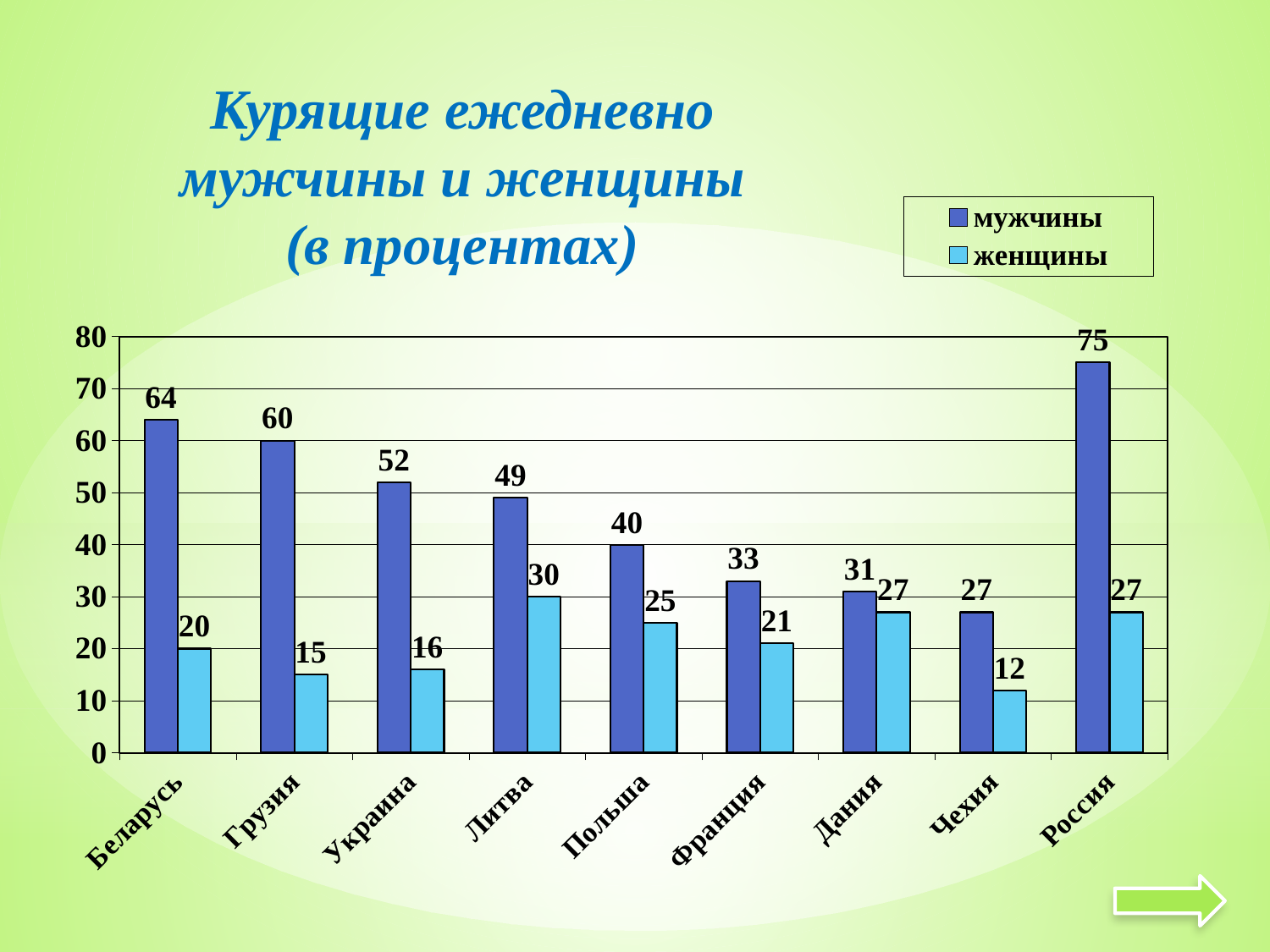
How many countries are shown on the x axis? 9 What is the value for мужчины in Россия? 75 Which country has the highest value for мужчины? Россия What is the value for женщины in Франция? 21 What kind of chart is shown on the slide? bar chart Which is larger: мужчины in Грузия or мужчины in Украина? Грузия What is the difference between мужчины and женщины in Беларусь? 44 Which colour represents женщины in the legend? light blue Which country has the lowest value for женщины? Чехия How many series does the legend list? 2 What is the difference between мужчины in Россия and мужчины in Чехия? 48 What is the value for женщины in Литва? 30